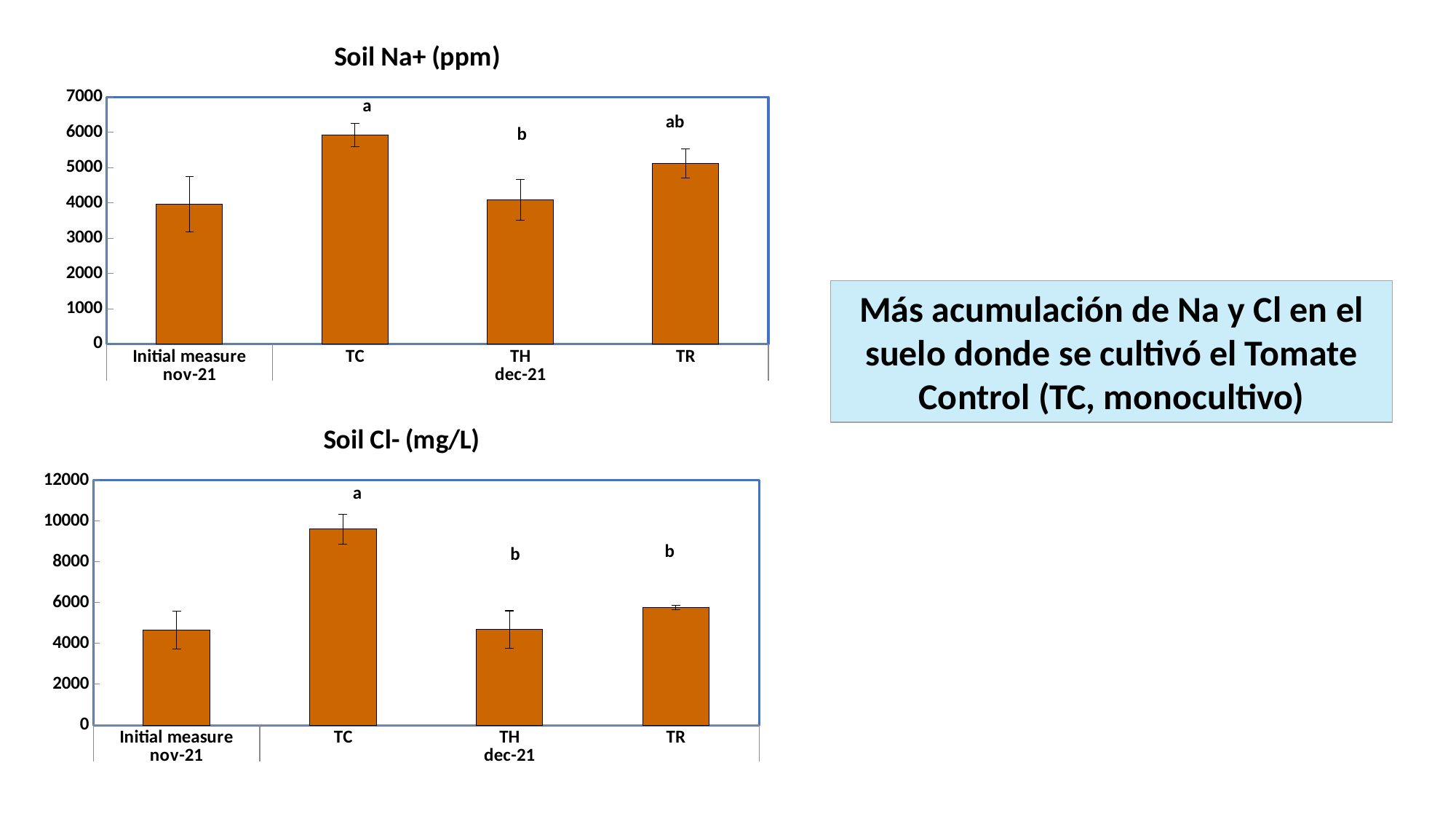
What kind of chart is the "Soil Na+ (ppm)" chart? bar chart In the "Soil Na+ (ppm)" chart, which is larger, the value for TC or the value for TR? TC In the "Soil Na+ (ppm)" chart, which category has the highest value? TC In the "Soil Cl- (mg/L)" chart, is the value for TC greater or less than 8000? greater In the "Soil Cl- (mg/L)" chart, which category has the highest value? TC In the "Soil Na+ (ppm)" chart, is the value for TC greater or less than 5000? greater In the "Soil Na+ (ppm)" chart, what letter label appears above the TR bar? ab In the "Soil Na+ (ppm)" chart, is the value for TH greater or less than 5000? less In the "Soil Cl- (mg/L)" chart, which is larger, the value for TR or the value for TH? TR What is the title of the bottom chart on the slide? Soil Cl- (mg/L) How many categories are shown on the x axis of the "Soil Cl- (mg/L)" chart? 4